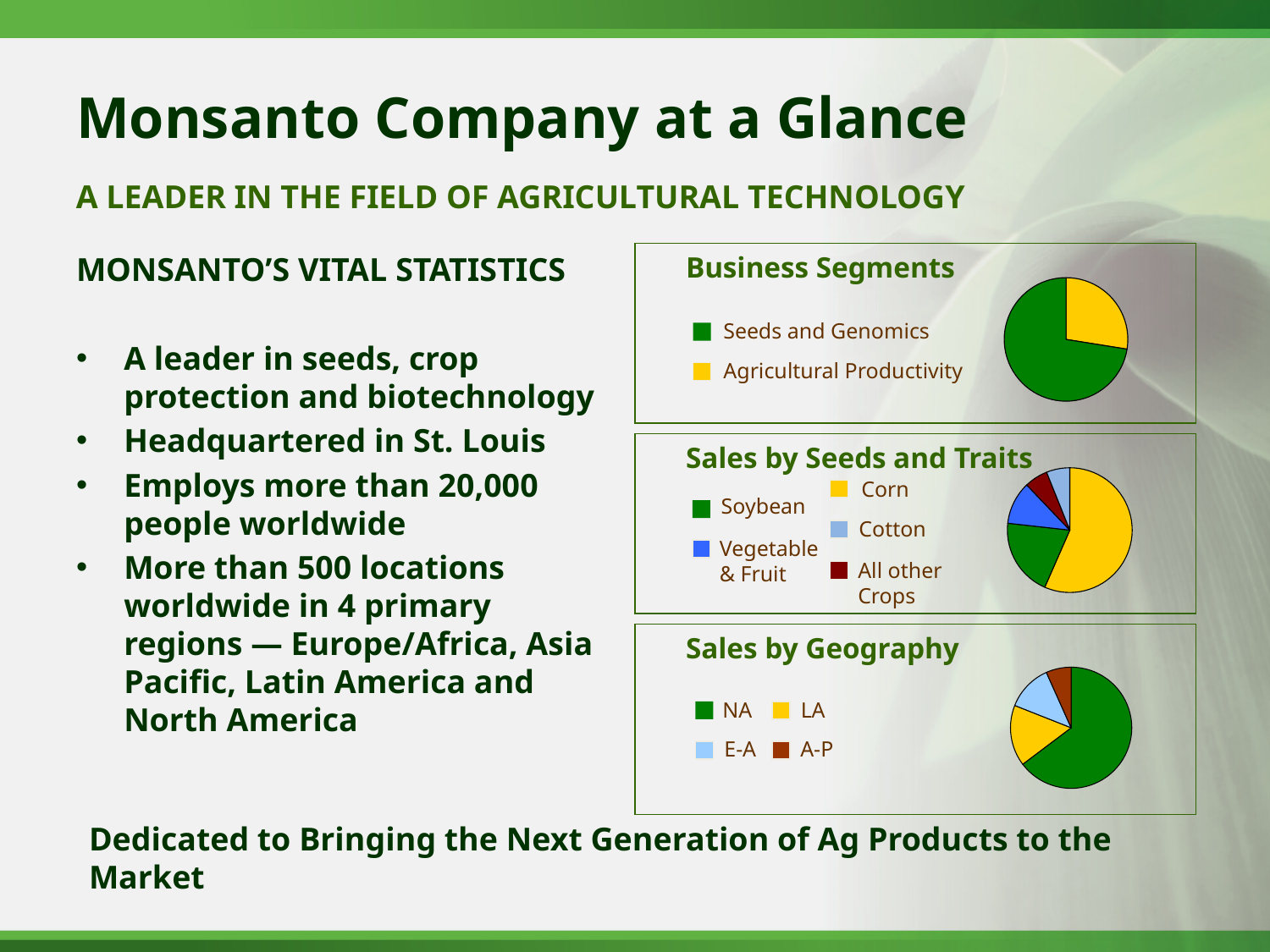
What kind of chart is used in the Business Segments panel? Pie chart How many charts are shown on the slide? 3 In the Sales by Seeds and Traits chart, which category has the largest share? Corn In the Sales by Seeds and Traits chart, which is larger: Soybean or Vegetable & Fruit? Soybean In the Sales by Geography chart, which region has the smallest share? A-P In the Sales by Geography chart, which region has the largest share? NA In the Sales by Seeds and Traits chart, what colour represents Corn? Yellow In the Business Segments chart, which is larger: Seeds and Genomics or Agricultural Productivity? Seeds and Genomics In the Sales by Geography chart, how many regions does the legend list? 4 In the Business Segments chart, which segment has the largest share? Seeds and Genomics In the Business Segments chart, how many segments does the legend list? 2 In the Sales by Seeds and Traits chart, how many categories does the legend list? 5